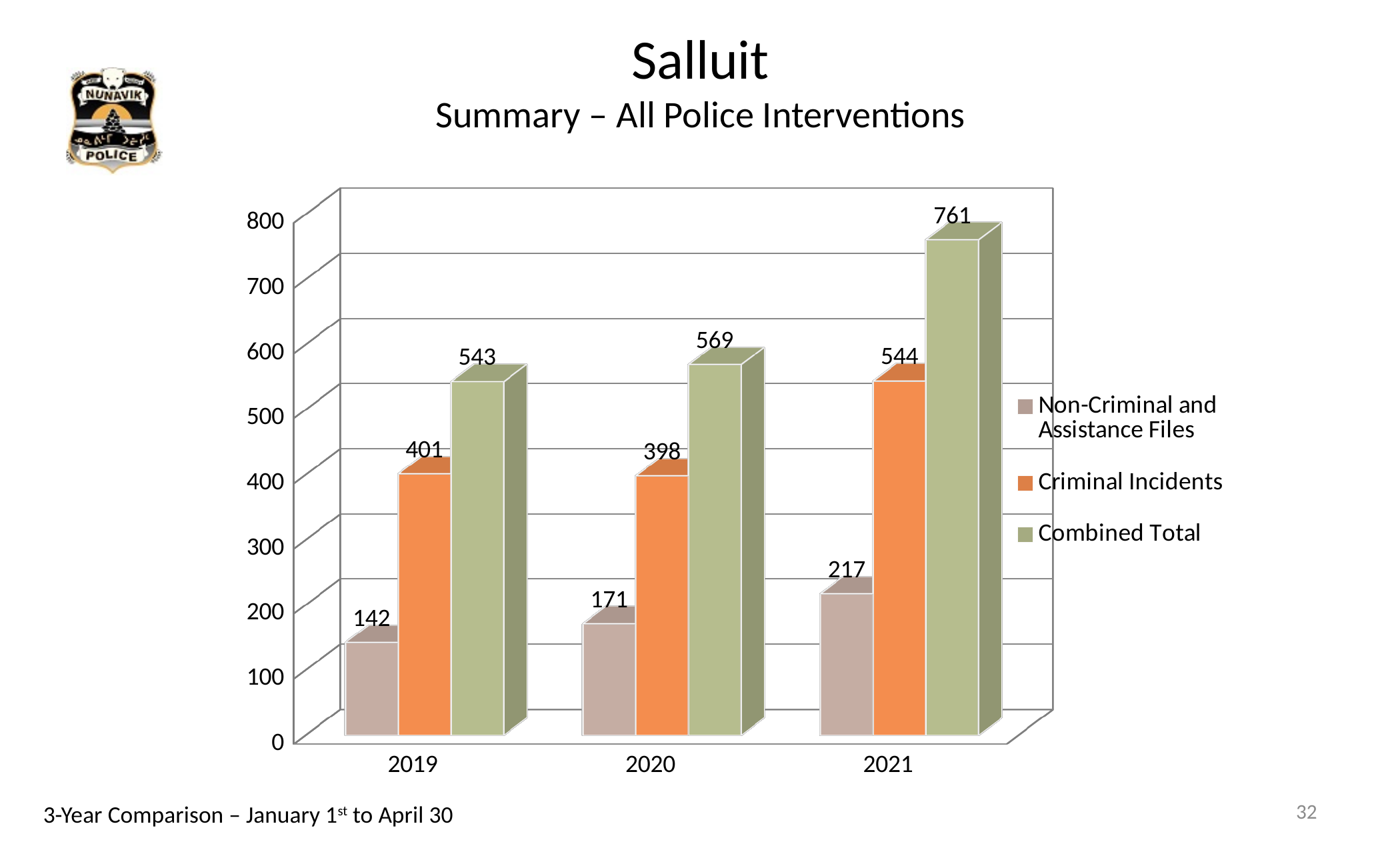
What is the difference between the Combined Total in 2021 and in 2019? 218 Is the value for Criminal Incidents in 2021 greater or less than 500? greater What is the value for Criminal Incidents in 2021? 544 What is the Combined Total for 2020? 569 How many series does the legend list? 3 How many years are shown on the x axis? 3 Which year has the lowest value for Non-Criminal and Assistance Files? 2019 Does the Non-Criminal and Assistance Files series rise or fall from 2019 to 2021? rise What is the value for Non-Criminal and Assistance Files in 2019? 142 Which is larger: Criminal Incidents in 2019 or Criminal Incidents in 2020? 2019 What kind of chart is shown on the slide? bar chart Which year has the highest Combined Total? 2021